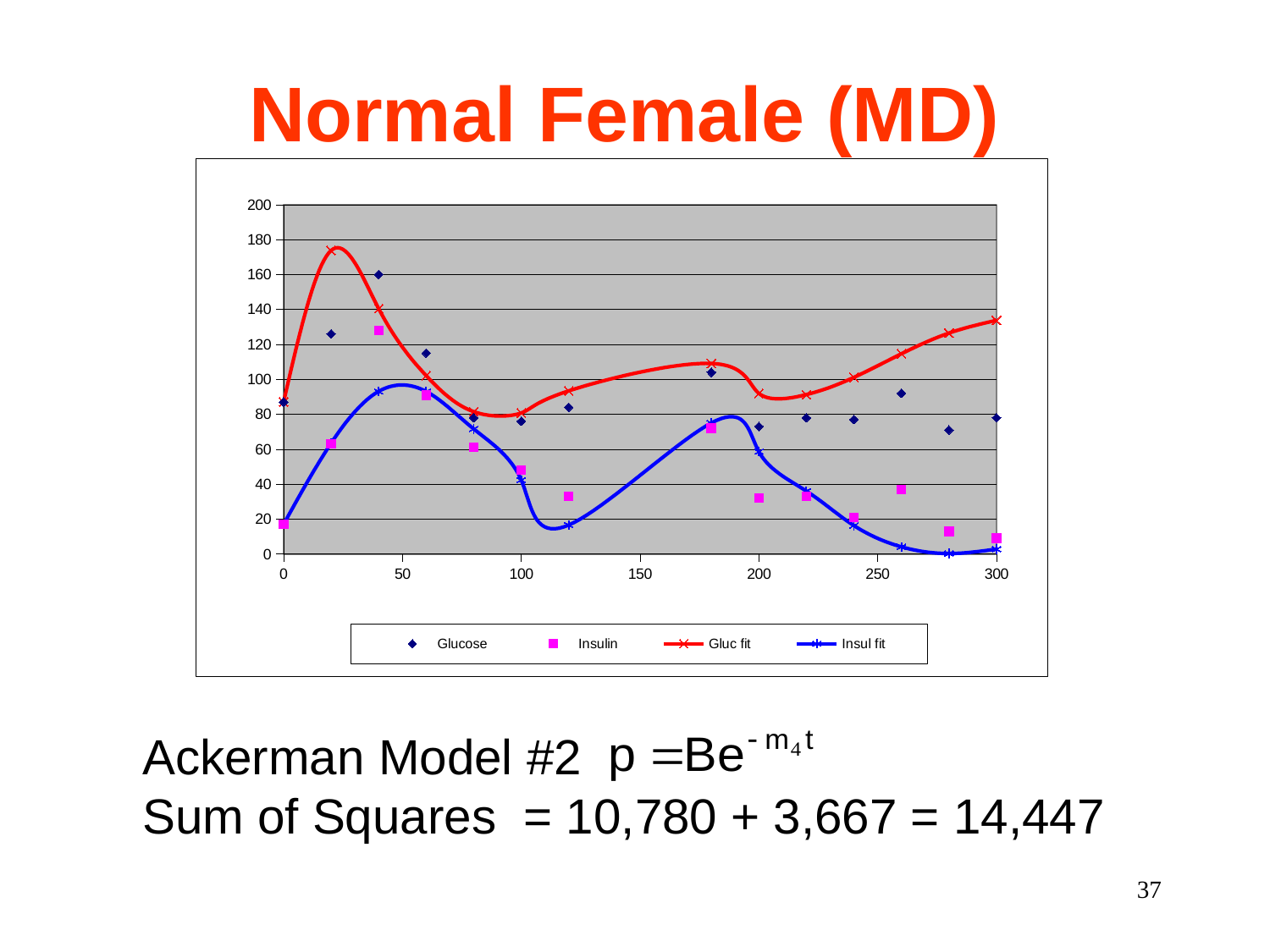
How many series does the chart legend list? 4 Is the Insulin value at x = 280 greater or less than 20? less Does the Insulin series rise or fall from x = 180 to x = 300? fall At which x value does the Glucose series reach its highest point? 40 At x = 0, which is larger, the Glucose value or the Insulin value? Glucose At which x value does the Insulin series reach its highest point? 40 Is the Glucose value at x = 280 greater or less than 80? less Is the Glucose value at x = 40 greater or less than 140? greater What kind of chart is shown on the slide? line chart (scatter points with fitted lines) At which x value is the Insulin series lowest? 300 What colour is the Gluc fit line in the chart? red